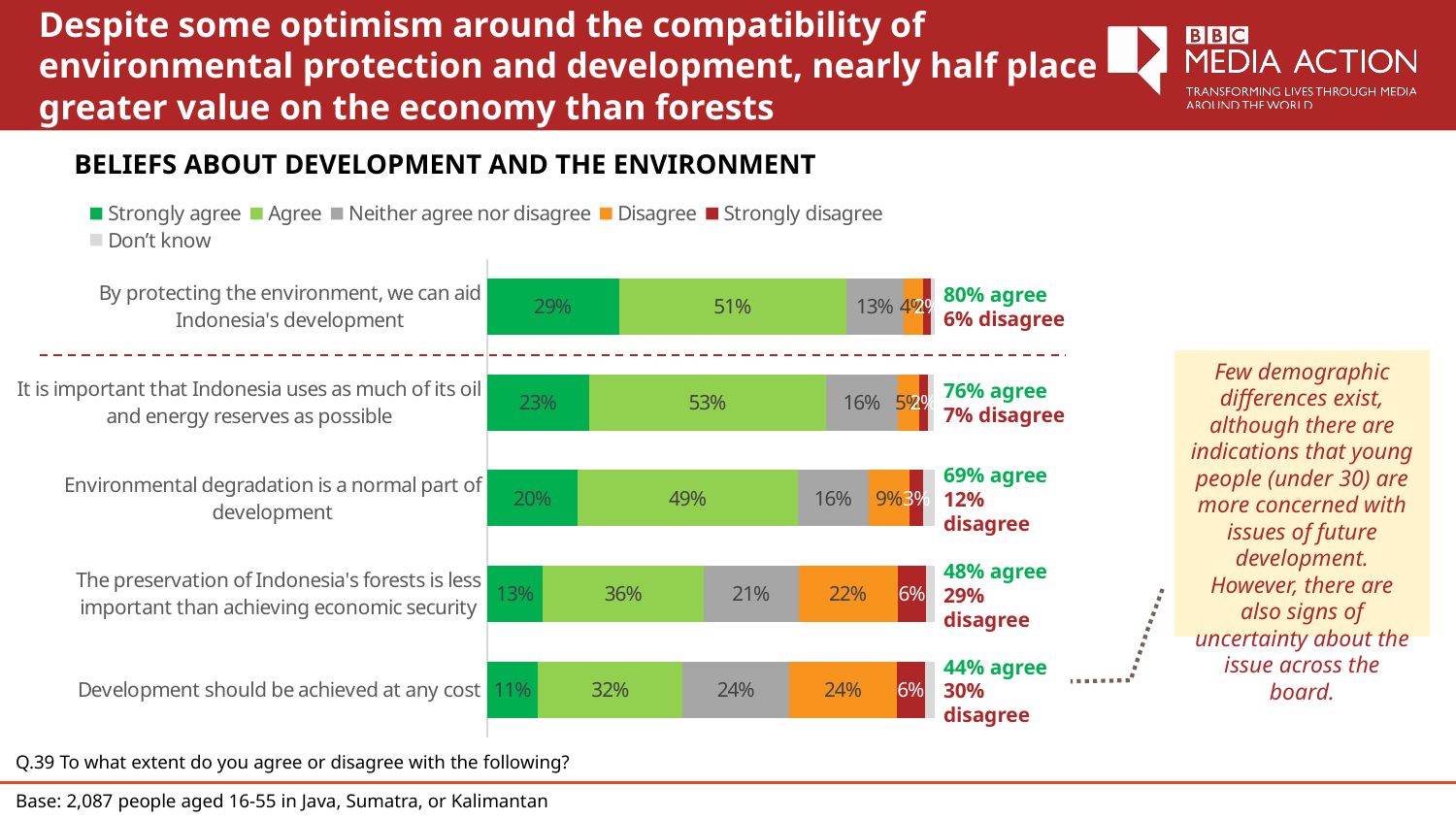
What percentage agree that it is important that Indonesia uses as much of its oil and energy reserves as possible? 53% What is the difference between the 'Agree' share for 'Environmental degradation is a normal part of development' and the 'Agree' share for 'Development should be achieved at any cost'? 17% What percentage strongly agree that by protecting the environment, we can aid Indonesia's development? 29% What percentage disagree that development should be achieved at any cost? 24% Which is larger: the 'Disagree' share for 'The preservation of Indonesia's forests is less important than achieving economic security' or the 'Disagree' share for 'Environmental degradation is a normal part of development'? The preservation of Indonesia's forests is less important than achieving economic security Which statement has the highest 'Strongly agree' share? By protecting the environment, we can aid Indonesia's development How many statements are plotted in the chart? 5 Which statement has the lowest 'Strongly agree' share? Development should be achieved at any cost What percentage neither agree nor disagree that the preservation of Indonesia's forests is less important than achieving economic security? 21% How many series does the legend list? 6 What is the title of the chart? BELIEFS ABOUT DEVELOPMENT AND THE ENVIRONMENT What kind of chart is shown on the slide? Stacked bar chart